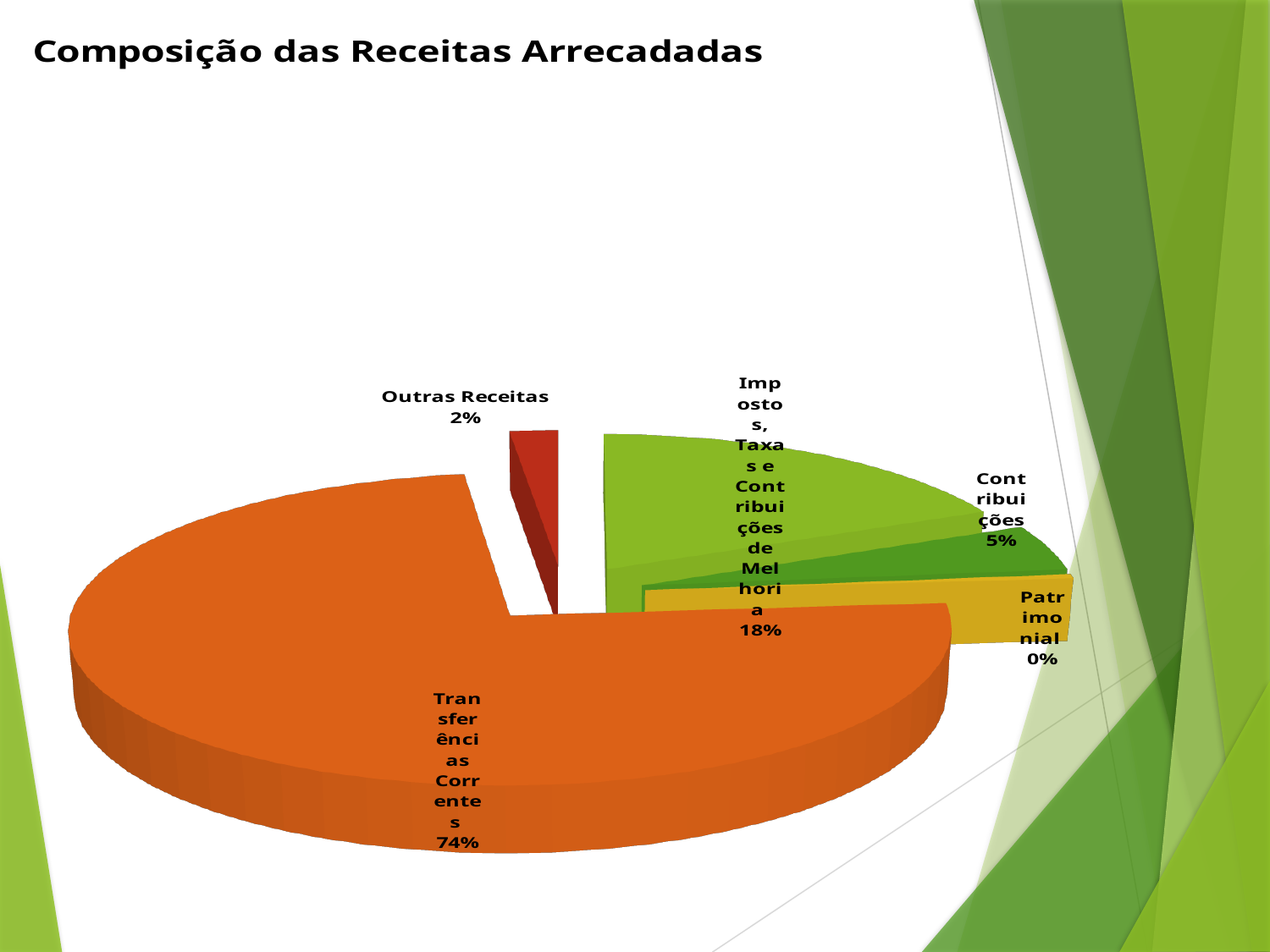
What share of the pie does Patrimonial represent? 0% What share of the pie does Contribuições represent? 5% What share of the pie does Outras Receitas represent? 2% What is the difference in percentage points between Transferências Correntes and Impostos, Taxas e Contribuições de Melhoria? 56 What is the title of the chart? Composição das Receitas Arrecadadas How many categories are shown in the pie chart? 5 Which is larger, the share for Contribuições or the share for Outras Receitas? Contribuições What kind of chart is shown on the slide? Pie chart Which category has the largest slice of the pie? Transferências Correntes Which category has the smallest slice of the pie? Patrimonial